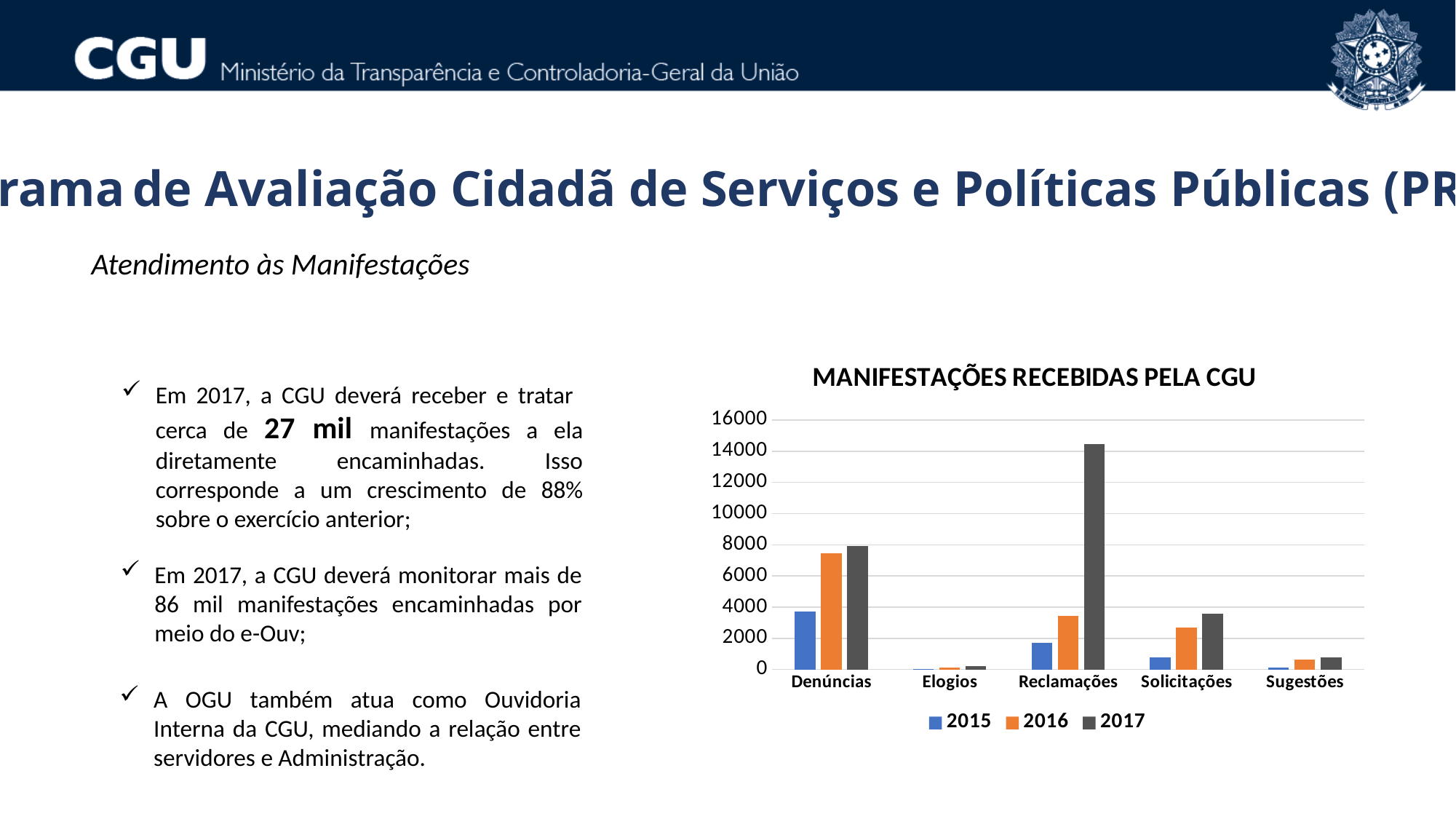
Is the 2017 value for Reclamações greater or less than 14000? greater What is the title of the chart? MANIFESTAÇÕES RECEBIDAS PELA CGU For Denúncias, do the values rise or fall from 2015 to 2017? rise Which category has the highest value for the 2017 series? Reclamações Which category has the lowest value for the 2017 series? Elogios For Solicitações, which series has the larger value, 2015 or 2017? 2017 What kind of chart is shown on the slide? bar chart Is the 2016 value for Denúncias greater or less than 6000? greater Which years are listed in the chart's legend? 2015, 2016, 2017 How many categories are shown on the x axis of the chart? 5 Is the 2015 value for Denúncias greater or less than 4000? less How many series does the chart's legend list? 3